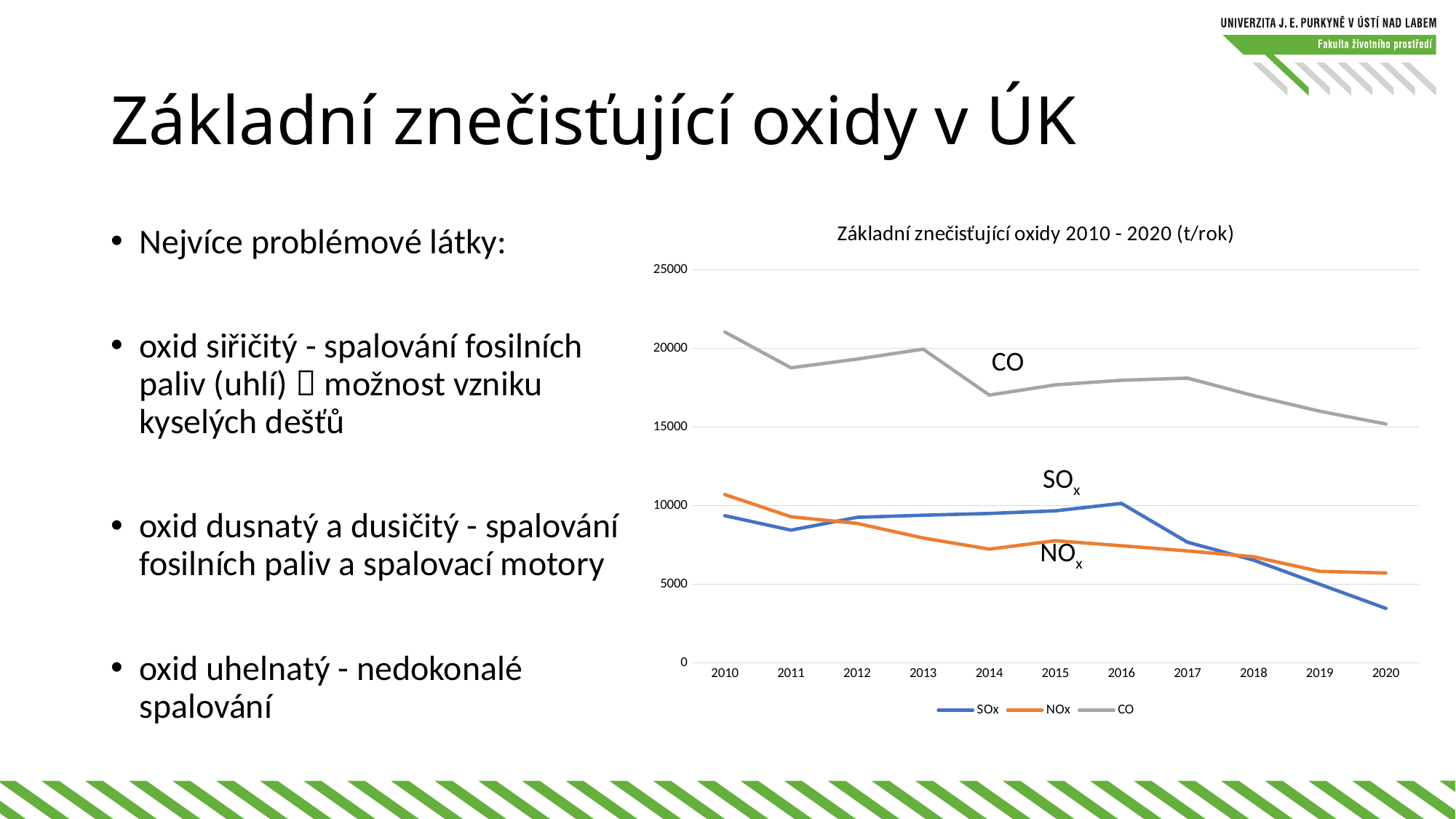
Which series is drawn in blue in the chart? SOx Is the value for SOx in 2020 greater or less than 5000? less In which year is the CO series at its highest? 2010 In which year is the SOx series at its lowest? 2020 Which is larger in 2020, SOx or NOx? NOx How many years are plotted along the x axis of the chart? 11 Is the value for CO in 2010 greater or less than 20000? greater How many series does the chart legend list? 3 Which series has the highest value in 2010? CO What kind of chart is shown on the slide? line chart What is the title of the chart? Základní znečisťující oxidy 2010 - 2020 (t/rok) Does the CO series generally rise or fall from 2010 to 2020? fall